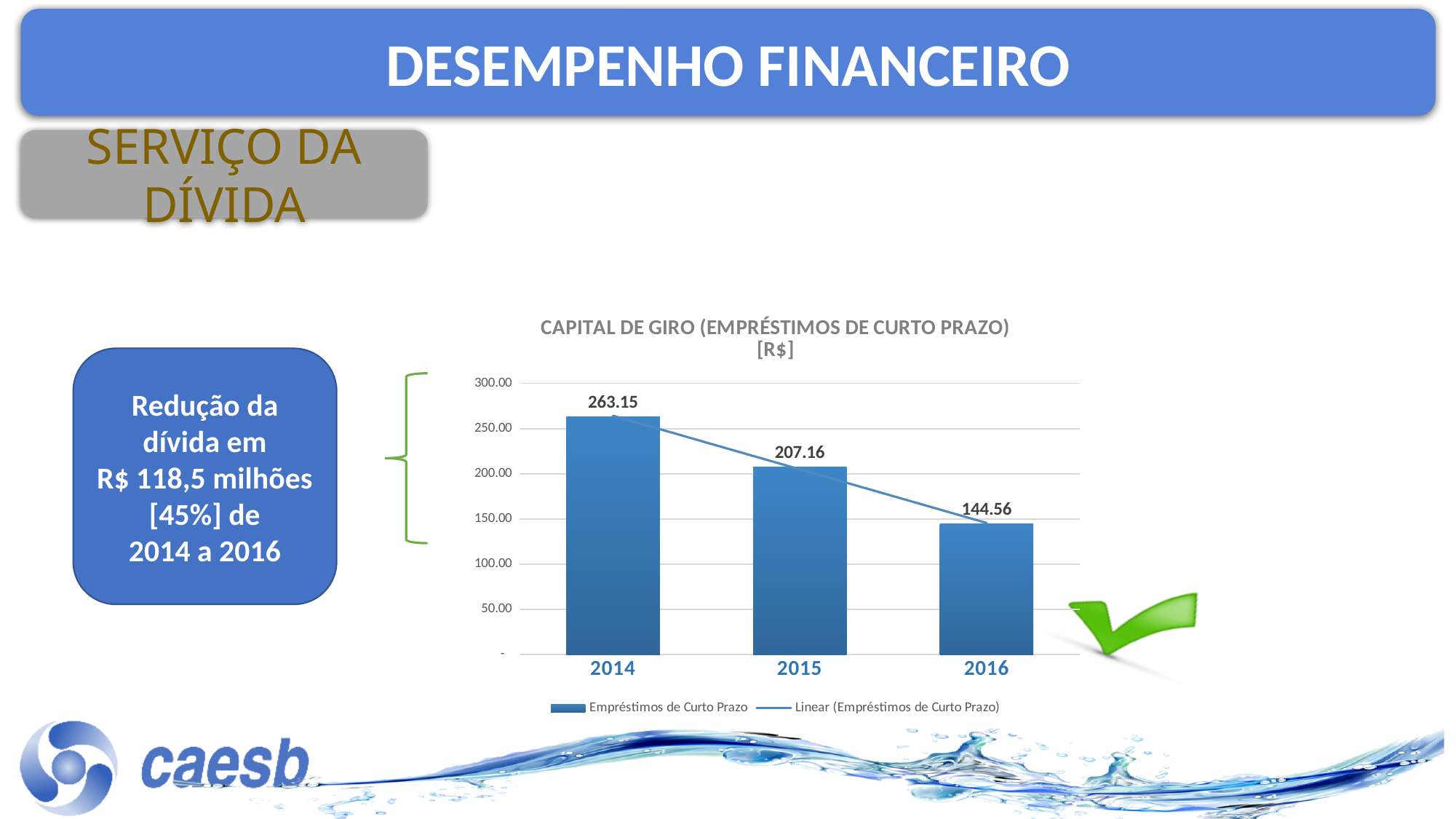
Is the value for 2015 greater or less than 200.00? greater Do the bar values rise or fall from 2014 to 2016? fall What is the difference between the values for 2014 and 2016? 118.59 What is the value for 2016 in the chart? 144.56 Which is larger, the value for 2015 or the value for 2016? 2015 What is the value for 2015 in the chart? 207.16 Which year has the highest value in the chart? 2014 Which year has the lowest value in the chart? 2016 What kind of chart is shown on the slide? bar chart What is the value for 2014 in the chart? 263.15 What is the difference between the values for 2014 and 2015? 55.99 How many years are shown on the x axis of the chart? 3